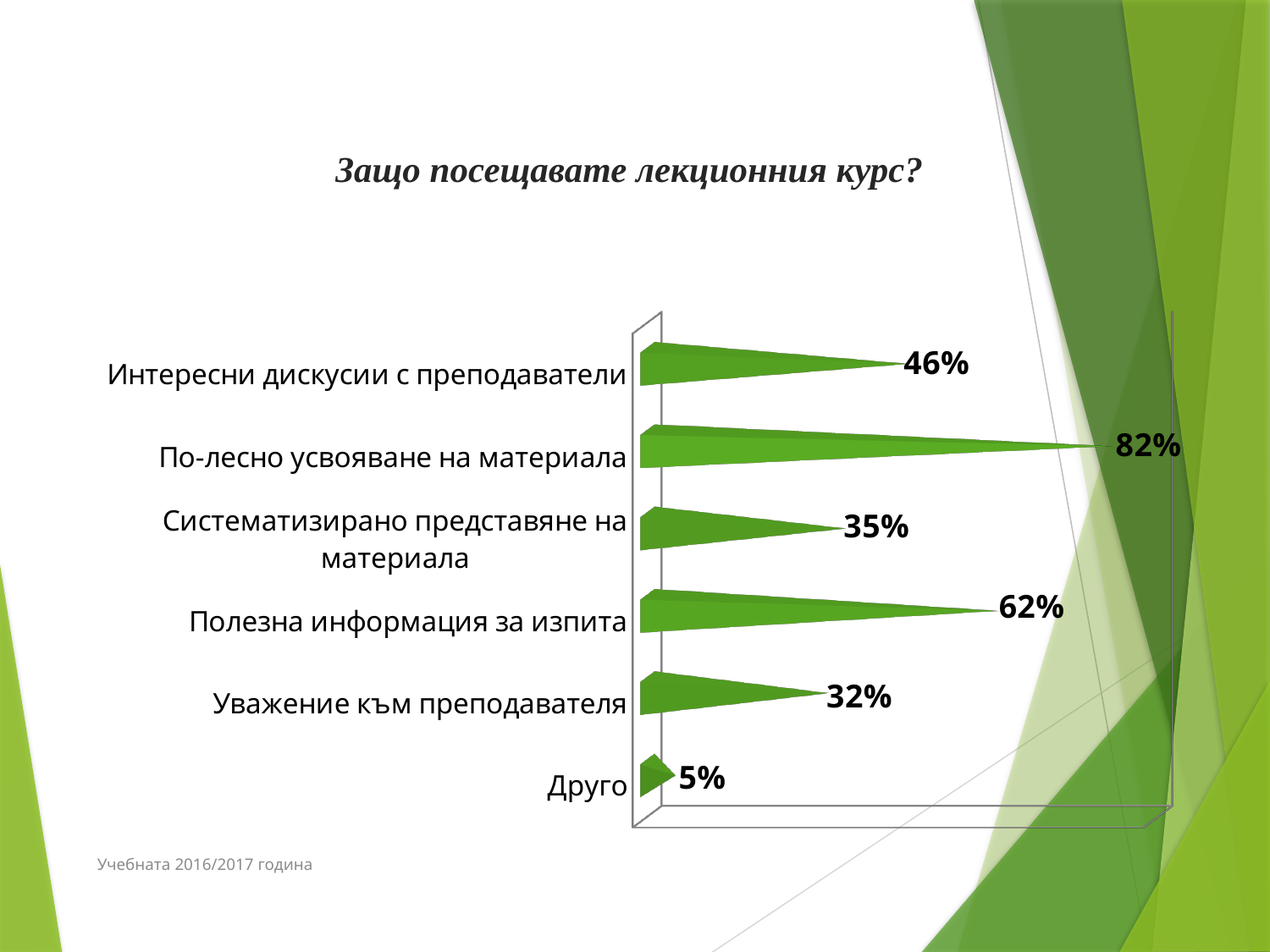
What is the value for "Интересни дискусии с преподаватели"? 46% How many categories are shown in the chart? 6 What is the title of the chart? Защо посещавате лекционния курс? Which category has the lowest value? Друго Which category has the highest value? По-лесно усвояване на материала What kind of chart is shown on the slide? Bar chart What is the difference between "По-лесно усвояване на материала" and "Полезна информация за изпита"? 20% Which is larger: "Полезна информация за изпита" or "Интересни дискусии с преподаватели"? Полезна информация за изпита What is the value for "По-лесно усвояване на материала"? 82% What is the value for "Уважение към преподавателя"? 32% What is the value for "Друго"? 5% What is the difference between "Интересни дискусии с преподаватели" and "Систематизирано представяне на материала"? 11%